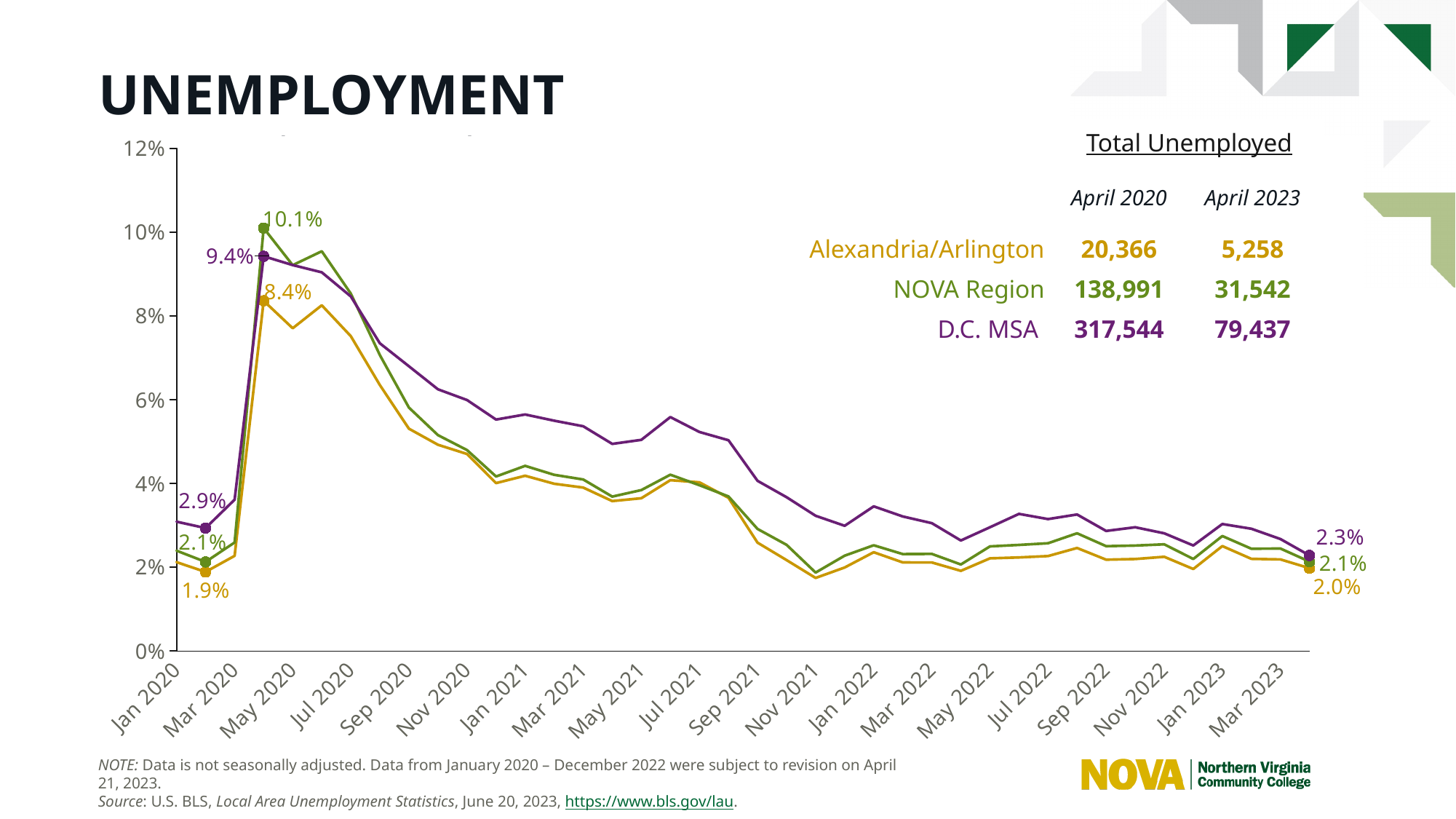
What was the unemployment rate labelled for Alexandria/Arlington in April 2020? 8.4% Which series had the highest labelled unemployment rate in April 2020? NOVA Region How many series are plotted on the chart? 3 What was the peak unemployment rate labelled for the NOVA Region in April 2020? 10.1% What was the unemployment rate labelled for the D.C. MSA in April 2020? 9.4% What is the most recent labelled unemployment rate for Alexandria/Arlington (April 2023)? 2.0% What type of chart is shown on the slide? line chart Which was larger in April 2020: the Alexandria/Arlington rate or the D.C. MSA rate? D.C. MSA What is the difference between the NOVA Region's April 2020 rate (10.1%) and its April 2023 rate (2.1%)? 8.0% Which series had the lowest labelled unemployment rate in February 2020? Alexandria/Arlington Is the D.C. MSA unemployment rate in June 2021 greater or less than 4%? greater What is the most recent labelled unemployment rate for the D.C. MSA (April 2023)? 2.3%